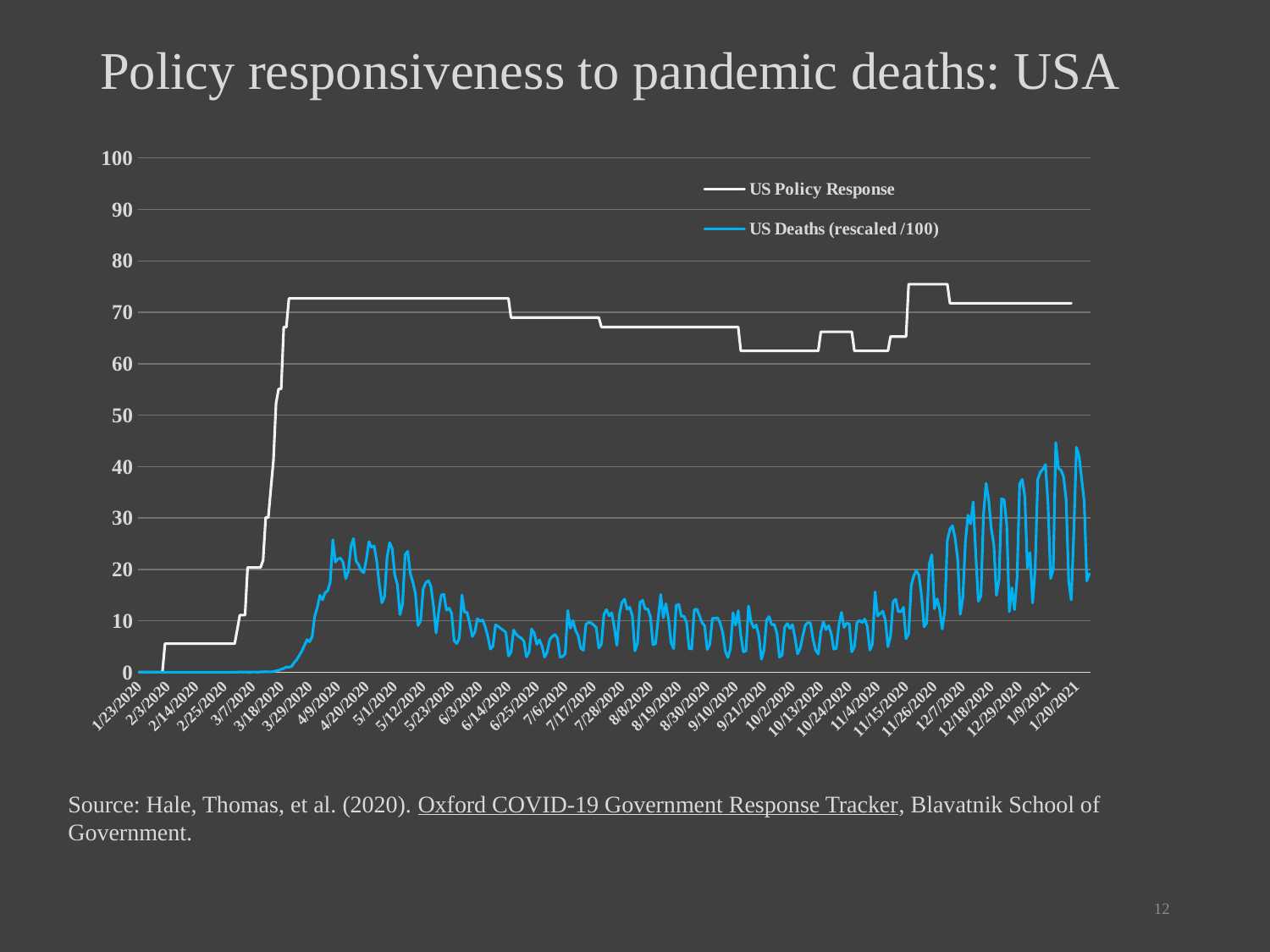
Is the peak value of US Deaths (rescaled /100) in January 2021 greater or less than 40? greater How many series does the legend list? 2 Is the value of US Policy Response on 10/2/2020 greater or less than 70? less What is the title of the chart on the slide? Policy responsiveness to pandemic deaths: USA Is the value of US Policy Response on 4/20/2020 greater or less than 70? greater What kind of chart is shown on the slide? line chart Does the US Policy Response line generally rise or fall between 4/20/2020 and 10/2/2020? fall What colour is the US Deaths (rescaled /100) line? blue Which series has the higher value on 6/3/2020, US Policy Response or US Deaths (rescaled /100)? US Policy Response Does the US Deaths (rescaled /100) line generally rise or fall between 11/4/2020 and 1/9/2021? rise